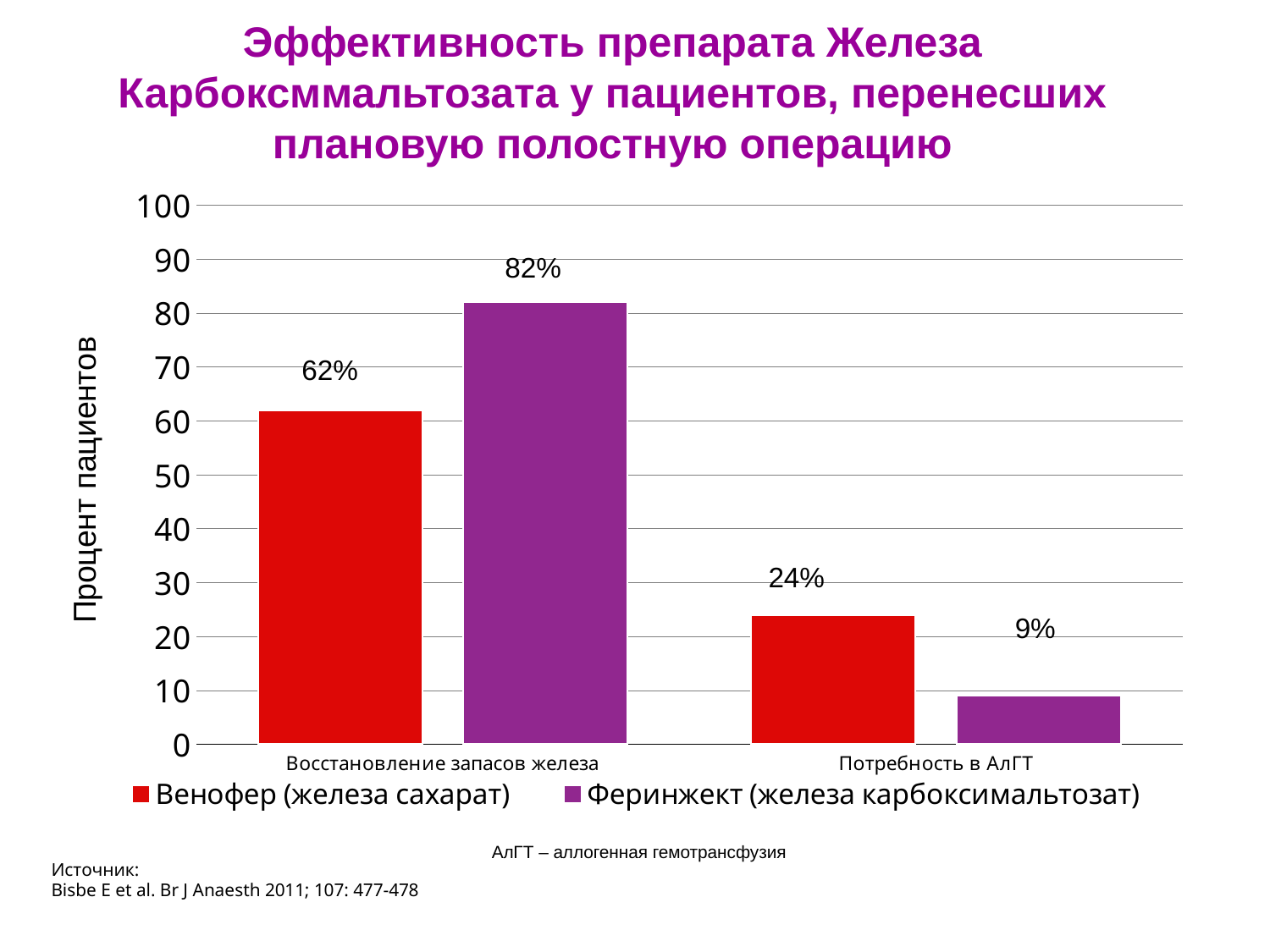
What is the difference between the Венофер and Феринжект values in the Потребность в АлГТ category? 15% What is the value for Венофер (железа сахарат) in the Восстановление запасов железа category? 62% Which series has the lowest value in the Потребность в АлГТ category? Феринжект (железа карбоксимальтозат) How many categories are shown on the x axis? 2 What is the value for Венофер (железа сахарат) in the Потребность в АлГТ category? 24% What is the value for Феринжект (железа карбоксимальтозат) in the Восстановление запасов железа category? 82% What kind of chart is shown on the slide? Bar chart Which series has the highest value in the Восстановление запасов железа category? Феринжект (железа карбоксимальтозат) Which is larger: the Венофер value for Восстановление запасов железа or the Венофер value for Потребность в АлГТ? Восстановление запасов железа What is the value for Феринжект (железа карбоксимальтозат) in the Потребность в АлГТ category? 9% How many series does the legend list? 2 What is the difference between the Феринжект and Венофер values in the Восстановление запасов железа category? 20%